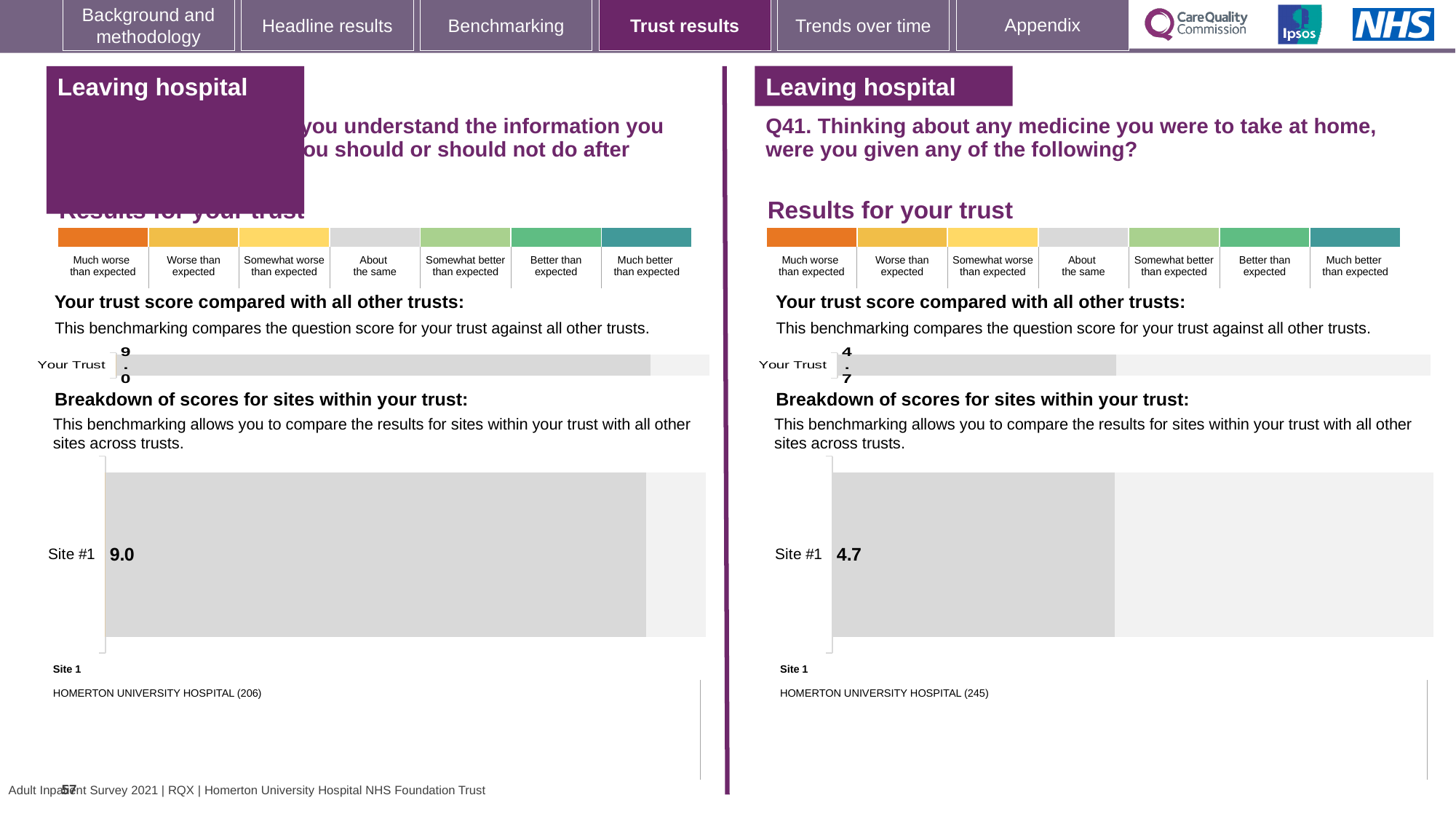
Which question number does the right-hand set of charts relate to? Q41 Which Your Trust score is larger: the one in the left-hand 'Your trust score' chart or the one in the right-hand 'Your trust score' chart (Q41)? The left-hand chart (9.0) How many sites are shown in the right-hand 'Breakdown of scores for sites within your trust' chart (Q41)? 1 In the right-hand 'Breakdown of scores for sites within your trust' chart (Q41), what is the score for Site #1? 4.7 According to the key below the right-hand breakdown chart (Q41), which hospital is Site 1? HOMERTON UNIVERSITY HOSPITAL (245) In the left-hand 'Your trust score compared with all other trusts' chart, what is the value shown for Your Trust? 9.0 What kind of chart is used to show the Site #1 score in the right-hand breakdown chart (Q41)? Bar chart What is the difference between the Site #1 score in the left-hand breakdown chart and the Site #1 score in the right-hand breakdown chart (Q41)? 4.3 How many sites are shown in the left-hand 'Breakdown of scores for sites within your trust' chart? 1 Which Site #1 score is larger: the one in the left-hand breakdown chart or the one in the right-hand breakdown chart (Q41)? The left-hand chart (9.0) In the right-hand 'Your trust score compared with all other trusts' chart (Q41), what is the value shown for Your Trust? 4.7 In the left-hand 'Breakdown of scores for sites within your trust' chart, what is the score for Site #1? 9.0